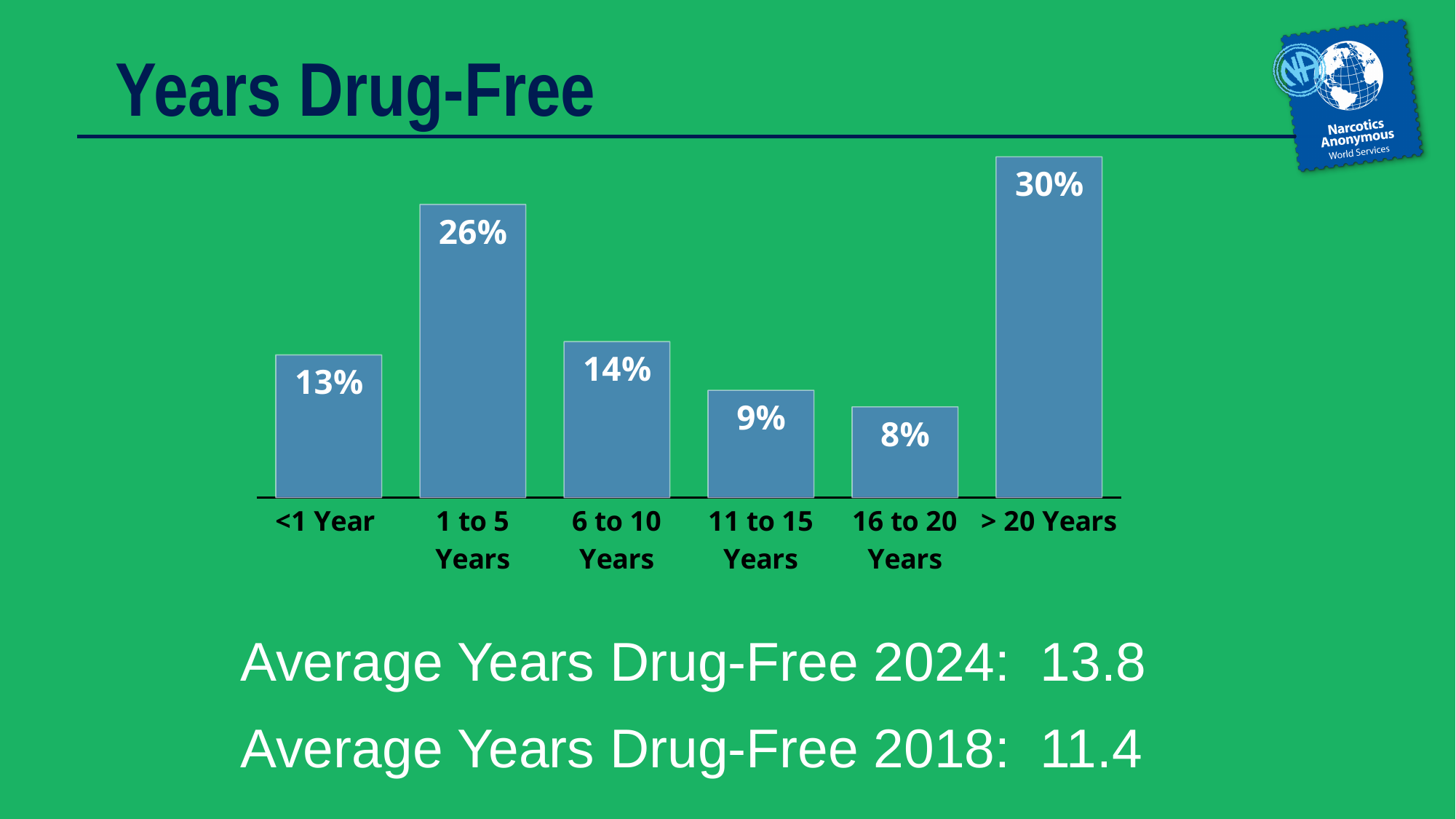
What percentage of respondents have been drug-free for less than 1 year? 13% What kind of chart is shown on the slide? Bar chart Which category has the highest percentage? > 20 Years Which category has the lowest percentage? 16 to 20 Years What is the combined percentage of the 11 to 15 Years and 16 to 20 Years categories? 17% What is the value for the 1 to 5 Years category? 26% What is the difference between the > 20 Years and 1 to 5 Years percentages? 4% What is the difference between the 6 to 10 Years and 11 to 15 Years values? 5% What is the title of the slide containing the chart? Years Drug-Free Which is larger, the value for <1 Year or the value for 6 to 10 Years? 6 to 10 Years How many categories are shown on the x axis of the chart? 6 What percentage is shown for 16 to 20 Years? 8%